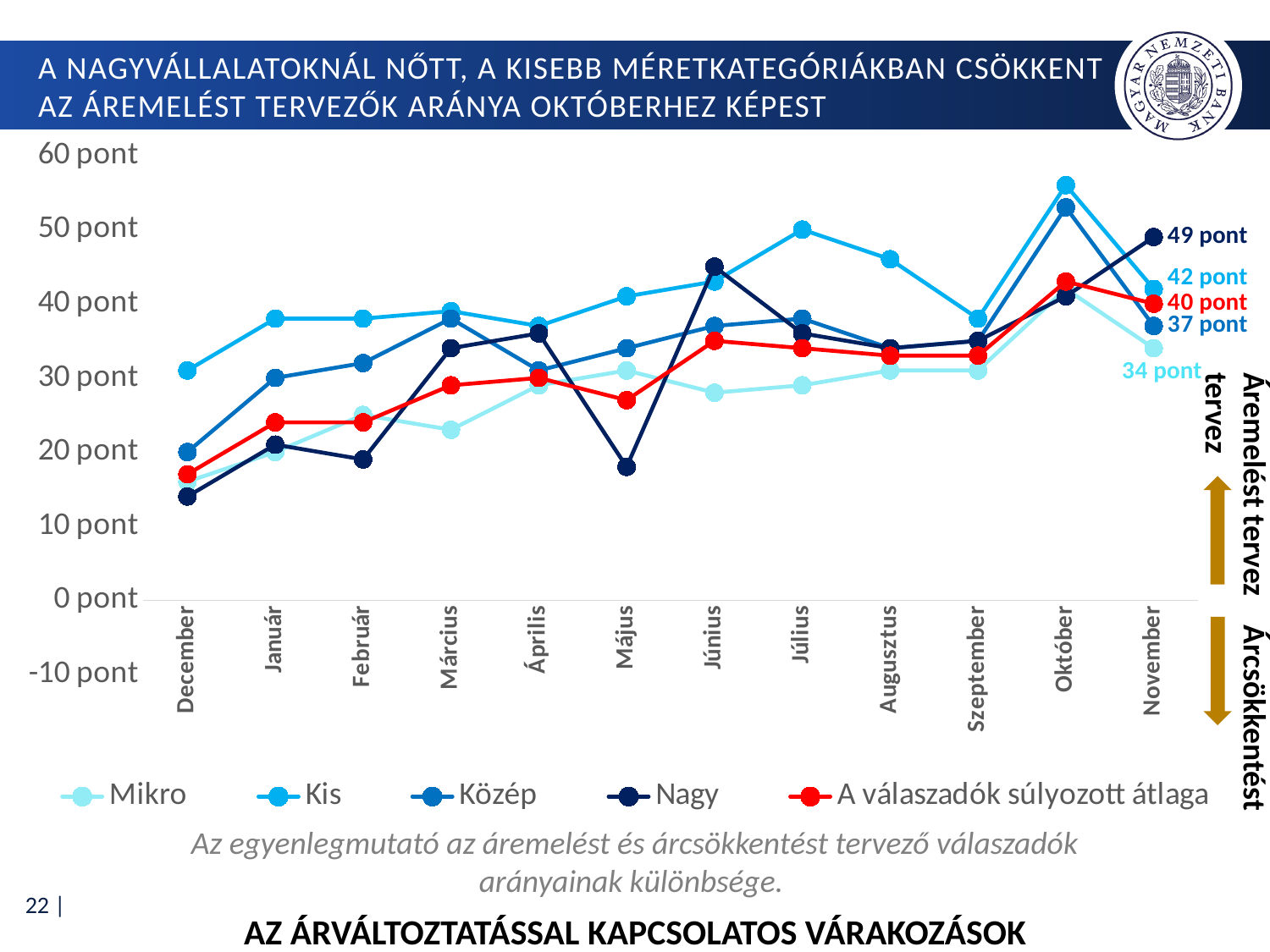
Which series has the highest value in November? Nagy What is the value for A válaszadók súlyozott átlaga in November? 40 pont Is the value for Kis in Október greater or less than 50 pont? greater Which series has the lowest value in November? Mikro What kind of chart is shown on the slide? line chart What is the difference between the Nagy and Mikro values in November? 15 pont How many series does the legend list? 5 Is the value for Nagy in Május greater or less than 20 pont? less What is the value for Mikro in November? 34 pont In November, which is larger: the value for Kis or the value for Közép? Kis What is the value for Kis in November? 42 pont What is the value for Nagy in November? 49 pont